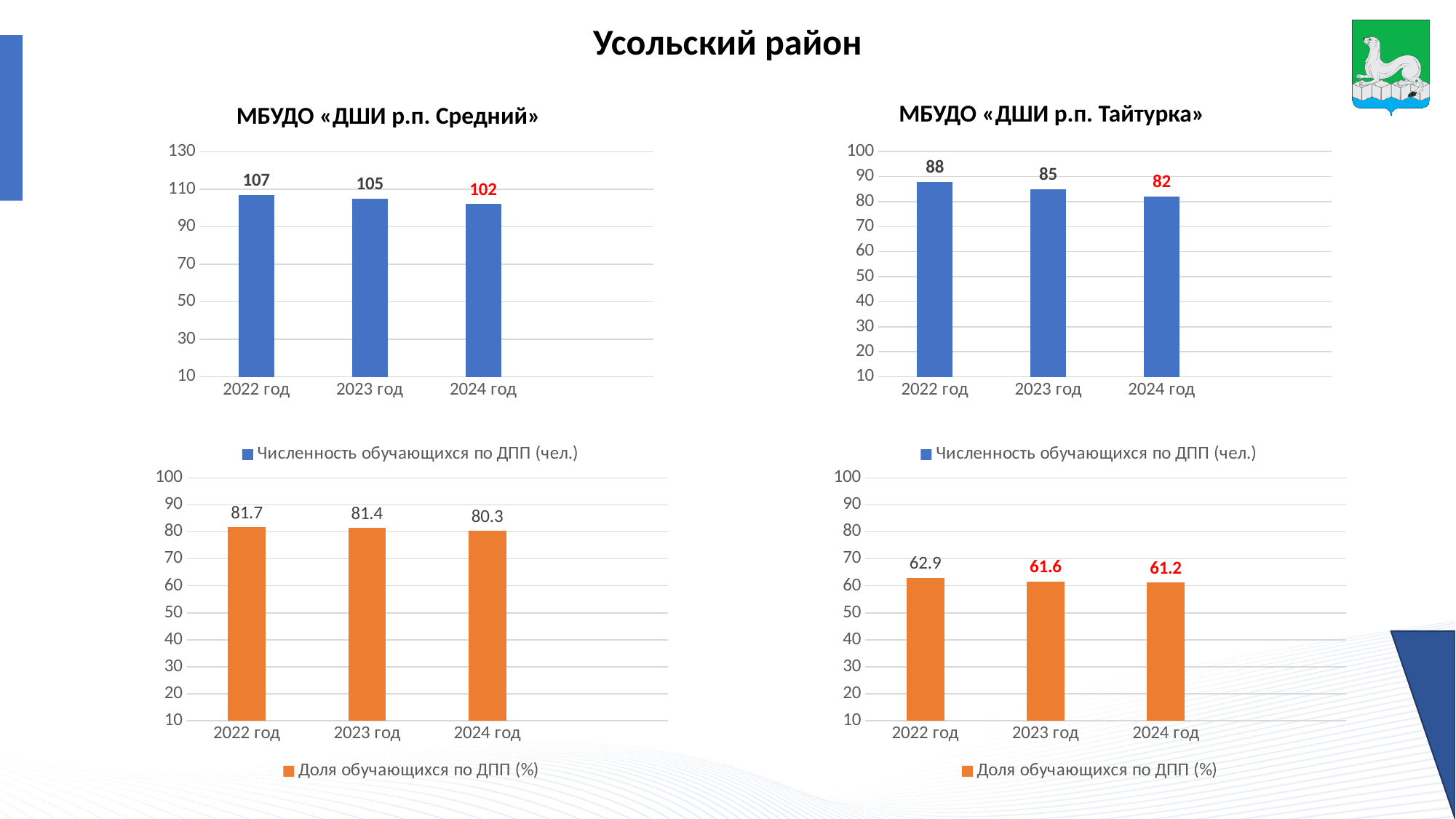
In the bottom-right chart (МБУДО «ДШИ р.п. Тайтурка», Доля обучающихся по ДПП), is the value for 2024 год greater or less than 70? less In the top-left chart (МБУДО «ДШИ р.п. Средний», Численность обучающихся по ДПП), what is the value for 2022 год? 107 What type of chart is the top-left chart (МБУДО «ДШИ р.п. Средний», Численность обучающихся по ДПП)? bar chart In the top-left chart (МБУДО «ДШИ р.п. Средний», Численность обучающихся по ДПП), what is the difference between the 2022 год and 2024 год values? 5 In the top-left chart (МБУДО «ДШИ р.п. Средний», Численность обучающихся по ДПП), which year has the lowest value? 2024 год In the bottom-right chart (МБУДО «ДШИ р.п. Тайтурка», Доля обучающихся по ДПП), what is the value for 2022 год? 62.9 In the bottom-left chart (МБУДО «ДШИ р.п. Средний», Доля обучающихся по ДПП), what is the value for 2024 год? 80.3 In the top-right chart (МБУДО «ДШИ р.п. Тайтурка», Численность обучающихся по ДПП), which year has the highest value? 2022 год In the top-right chart (МБУДО «ДШИ р.п. Тайтурка», Численность обучающихся по ДПП), do the values rise or fall from 2022 год to 2024 год? fall In the top-right chart (МБУДО «ДШИ р.п. Тайтурка», Численность обучающихся по ДПП), what is the value for 2023 год? 85 In the bottom-left chart (МБУДО «ДШИ р.п. Средний», Доля обучающихся по ДПП), what is the difference between the 2022 год and 2023 год values? 0.3 Which is larger: the 2023 год value in the bottom-left chart (Средний, Доля) or the 2023 год value in the bottom-right chart (Тайтурка, Доля)? bottom-left chart (Средний), 81.4